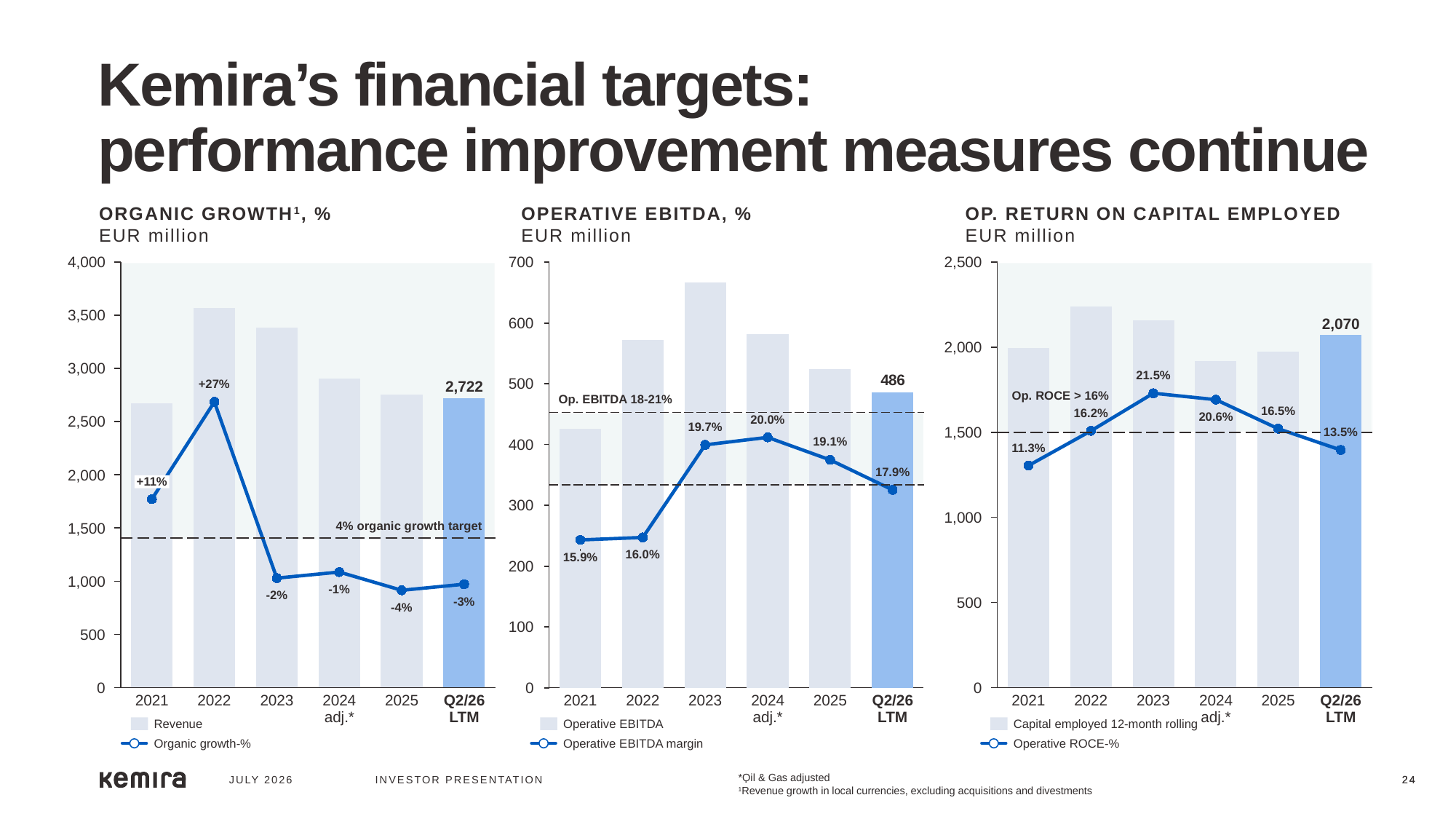
How many periods are shown on the x axis of the Organic Growth chart? 6 In the Operative EBITDA chart, which period has the highest operative EBITDA margin? 2024 adj.* In the Op. Return on Capital Employed chart, does the operative ROCE-% rise or fall from 2023 to Q2/26 LTM? fall In the Organic Growth chart, what is the organic growth-% for 2022? +27% In the Organic Growth chart, which year has the higher organic growth-%, 2021 or 2022? 2022 In the Organic Growth chart, what is the revenue value labelled for Q2/26 LTM? 2,722 In the Operative EBITDA chart, what is the operative EBITDA value labelled for Q2/26 LTM? 486 In the Op. Return on Capital Employed chart, what is the difference in operative ROCE-% between 2023 and Q2/26 LTM? 8.0 percentage points In the Op. Return on Capital Employed chart, which period has the lowest operative ROCE-%? 2021 What does the dashed line in the Organic Growth chart represent? 4% organic growth target In the Operative EBITDA chart, is the operative EBITDA bar for 2023 greater or less than 600? greater How many series does the legend of the Operative EBITDA chart list? 2